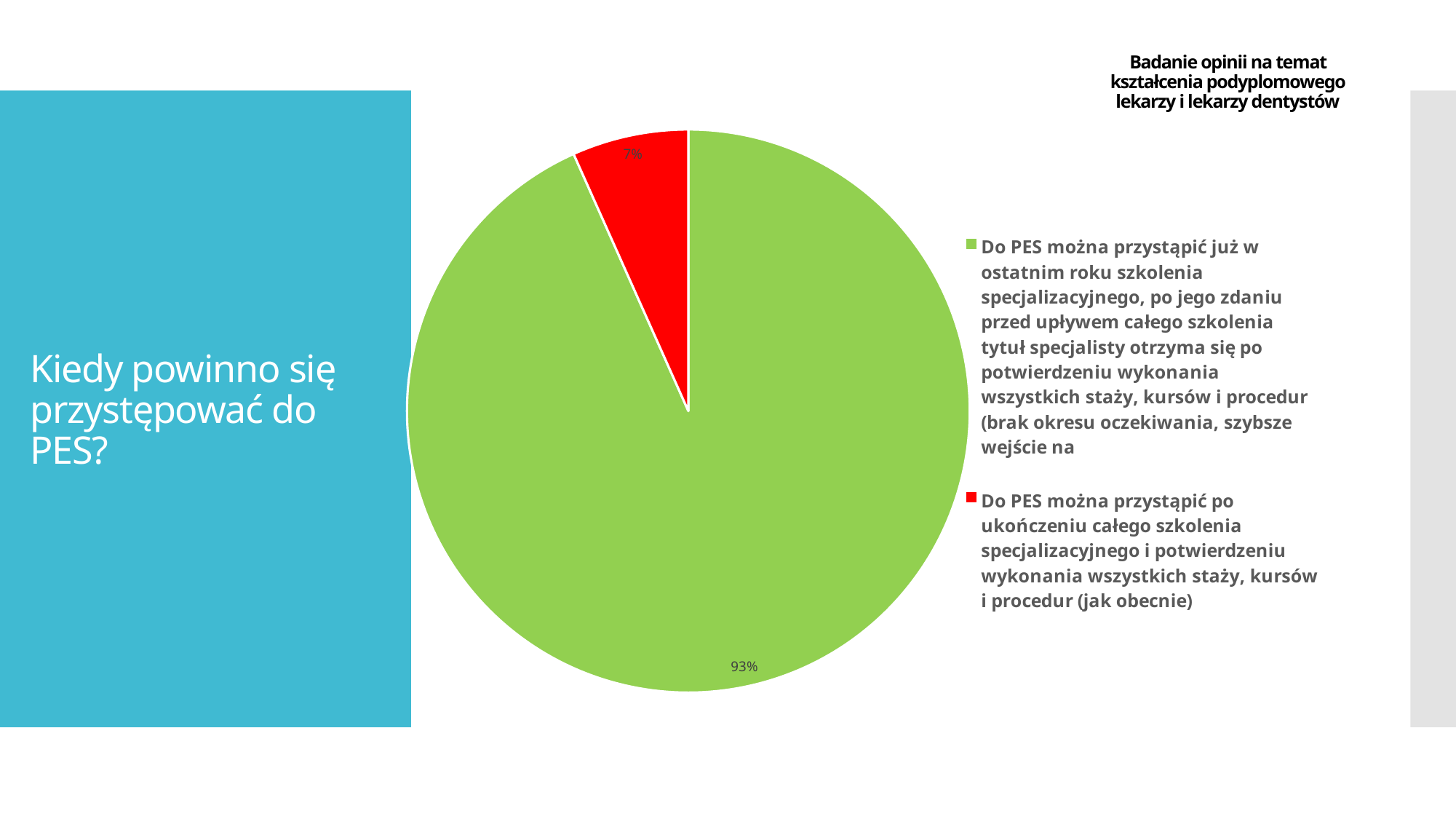
Which option has the largest share of the pie? Do PES można przystąpić już w ostatnim roku szkolenia specjalizacyjnego Which option has the smallest share of the pie? Do PES można przystąpić po ukończeniu całego szkolenia specjalizacyjnego (jak obecnie) Is the share of the red slice greater or less than 10%? less What share of the pie is the red slice (Do PES można przystąpić po ukończeniu całego szkolenia specjalizacyjnego...)? 7% What colour is the slice representing the option 'jak obecnie' (as currently)? red What is the difference in percentage points between the green slice and the red slice? 86 What kind of chart is shown on the slide? pie chart What question does the slide title ask? Kiedy powinno się przystępować do PES? Which slice is larger, the green one or the red one? the green one What share of the pie is the green slice (Do PES można przystąpić już w ostatnim roku szkolenia specjalizacyjnego...)? 93% How many entries does the legend list? 2 How many slices does the pie chart have? 2